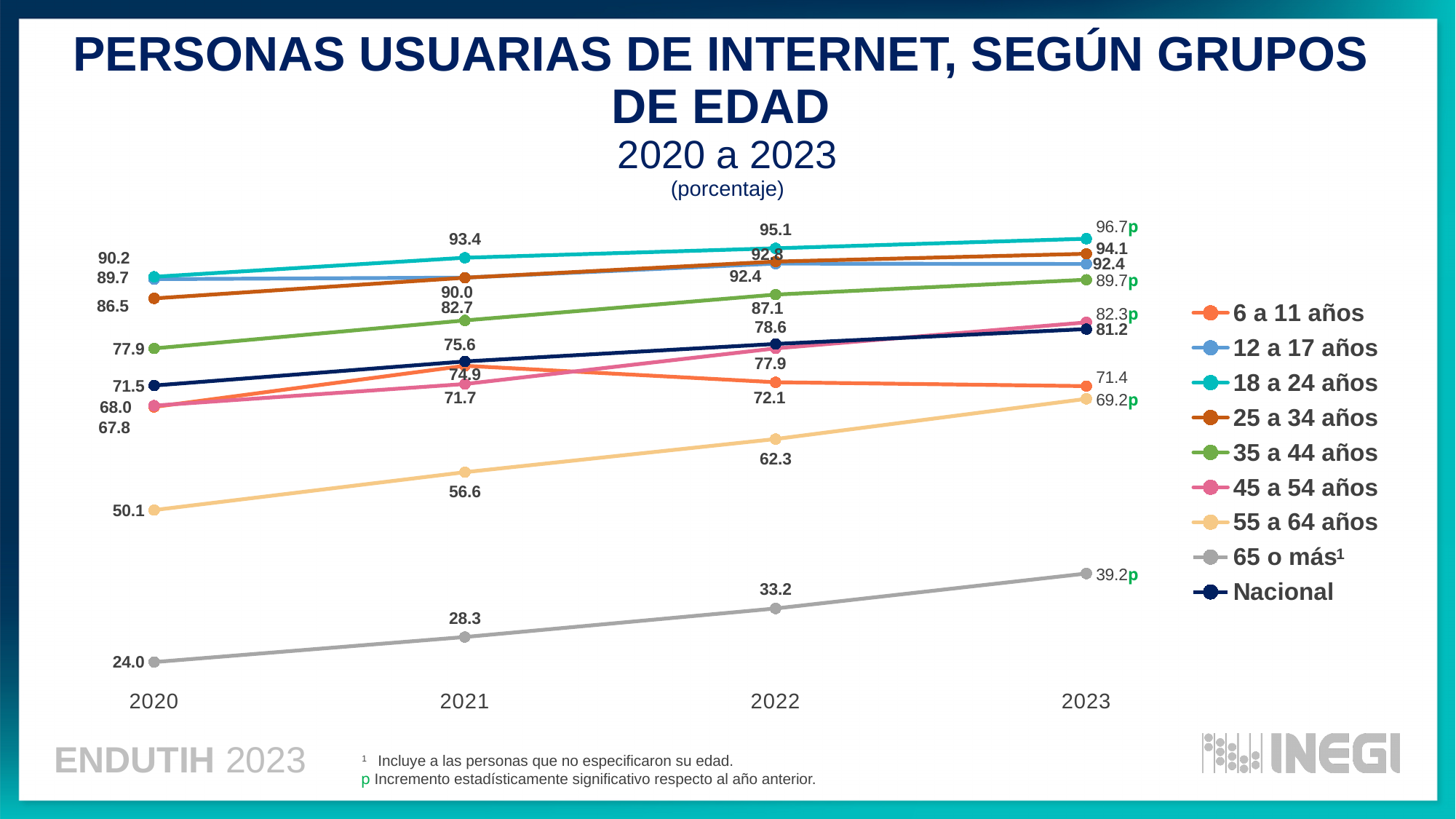
Which is larger in 2023, the value for 45 a 54 años or the Nacional value? 45 a 54 años What is the value for 65 o más in 2020? 24.0 Does the value for 65 o más rise or fall from 2020 to 2023? rise What type of chart is shown on the slide? line chart What is the value for 18 a 24 años in 2023? 96.7 Which age group has the lowest value in 2023? 65 o más What is the Nacional value in 2022? 78.6 Which age group has the highest value in 2023? 18 a 24 años What is the difference between the 18 a 24 años values in 2023 and 2020? 6.5 What is the value for 55 a 64 años in 2021? 56.6 How many years are shown on the x axis? 4 How many series does the legend list? 9